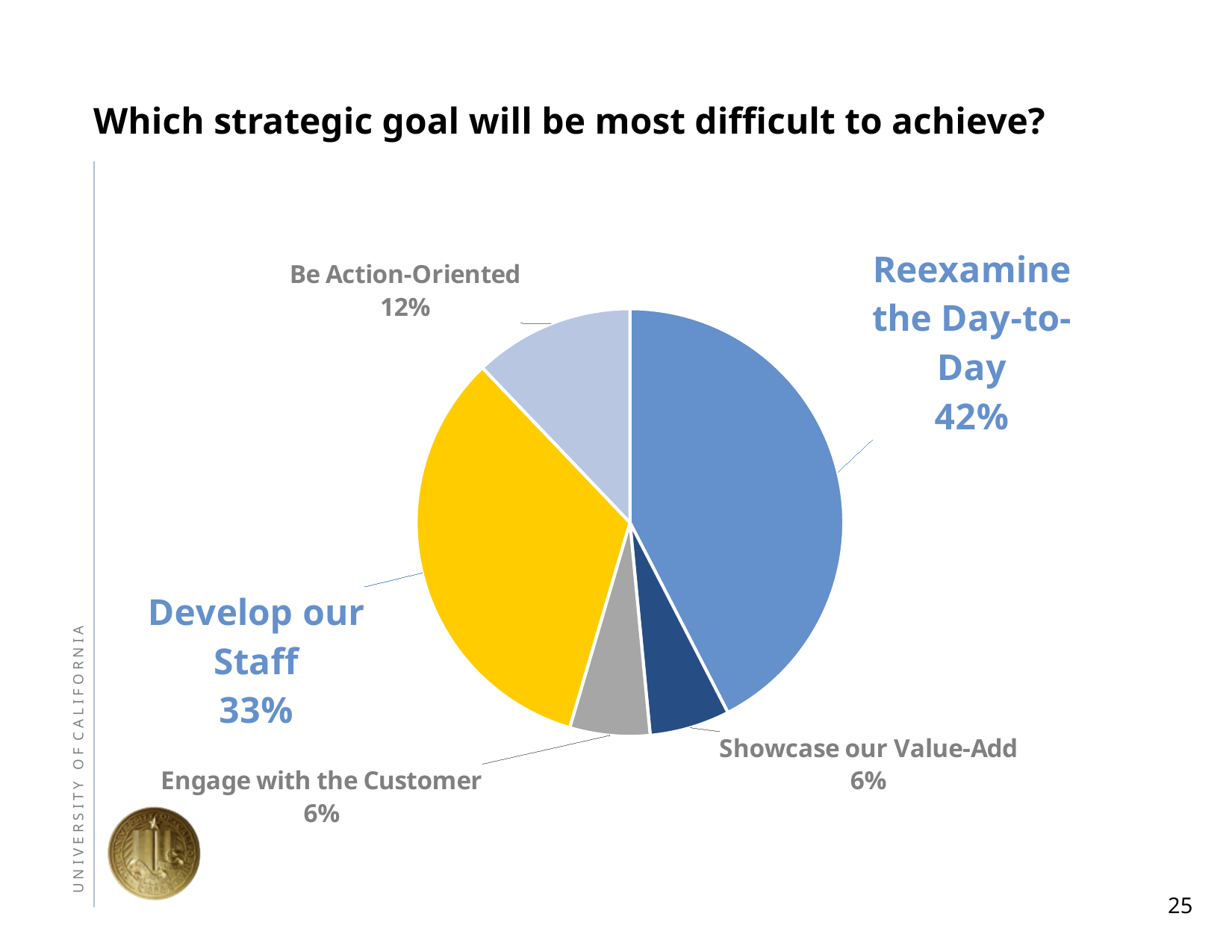
What share of the pie does "Develop our Staff" represent? 33% What is the title of the chart? Which strategic goal will be most difficult to achieve? What is the difference between the shares for "Reexamine the Day-to-Day" and "Develop our Staff"? 9% What kind of chart is shown on the slide? Pie chart What share of the pie does "Reexamine the Day-to-Day" represent? 42% What is the value shown for "Be Action-Oriented"? 12% Which strategic goal has the largest slice of the pie? Reexamine the Day-to-Day What is the difference between the shares for "Develop our Staff" and "Be Action-Oriented"? 21% What is the value shown for "Engage with the Customer"? 6% Which is larger, the share for "Be Action-Oriented" or the share for "Engage with the Customer"? Be Action-Oriented How many slices does the pie chart have? 5 What is the value shown for "Showcase our Value-Add"? 6%